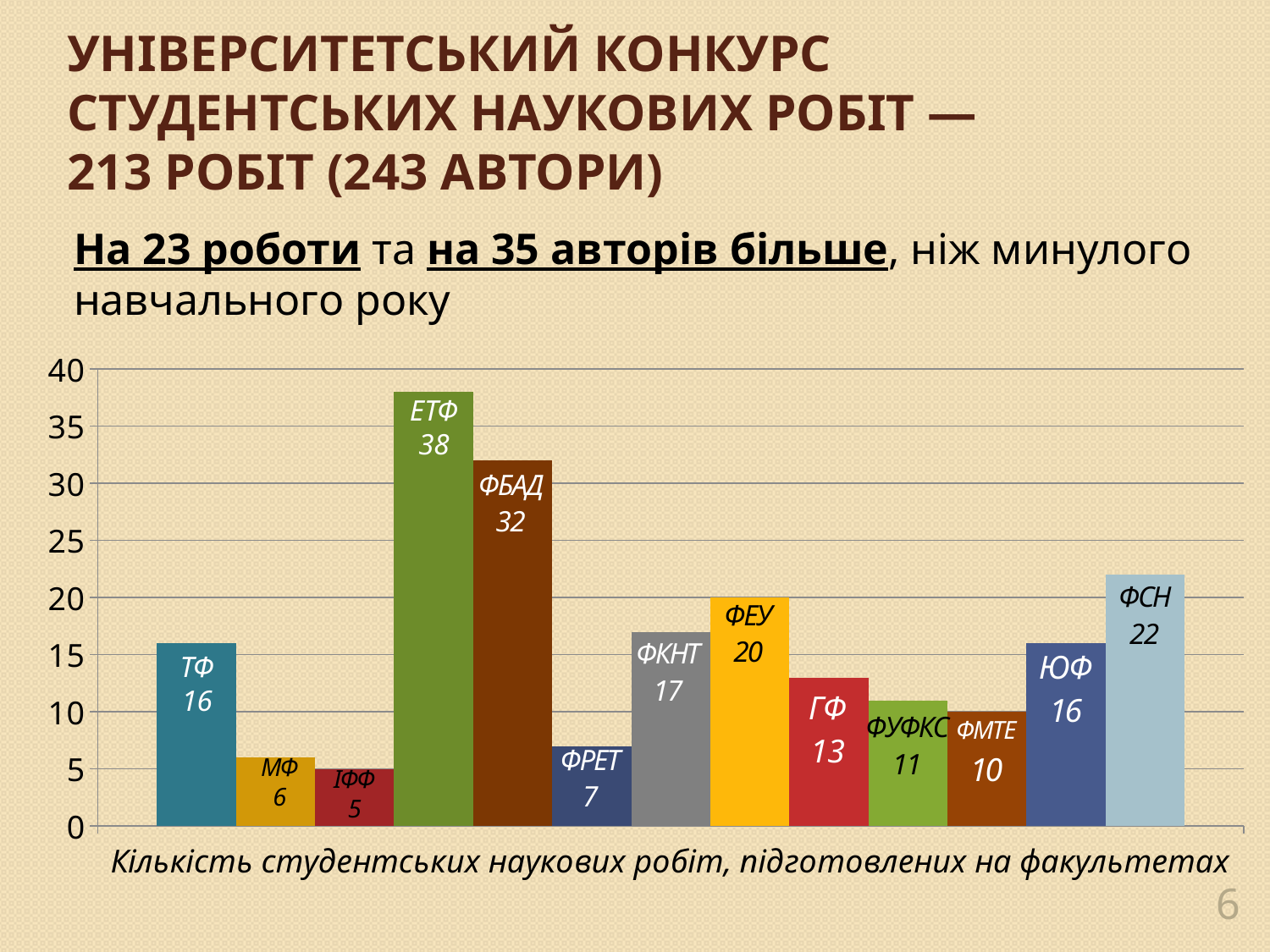
What is the value for ЕТФ? 38 Which faculty has the lowest value? ІФФ What is the value for ФУФКС? 11 What kind of chart is shown on the slide? bar chart What is the difference between the values for ФЕУ and ГФ? 7 Which faculty has the highest value? ЕТФ What is the value for ФСН? 22 What is the caption text shown below the chart? Кількість студентських наукових робіт, підготовлених на факультетах How many faculties (bars) are shown in the chart? 13 What is the difference between the values for ЕТФ and ФБАД? 6 Which is larger, the value for ФКНТ or the value for ЮФ? ФКНТ Is the value for ФБАД greater or less than 30? greater